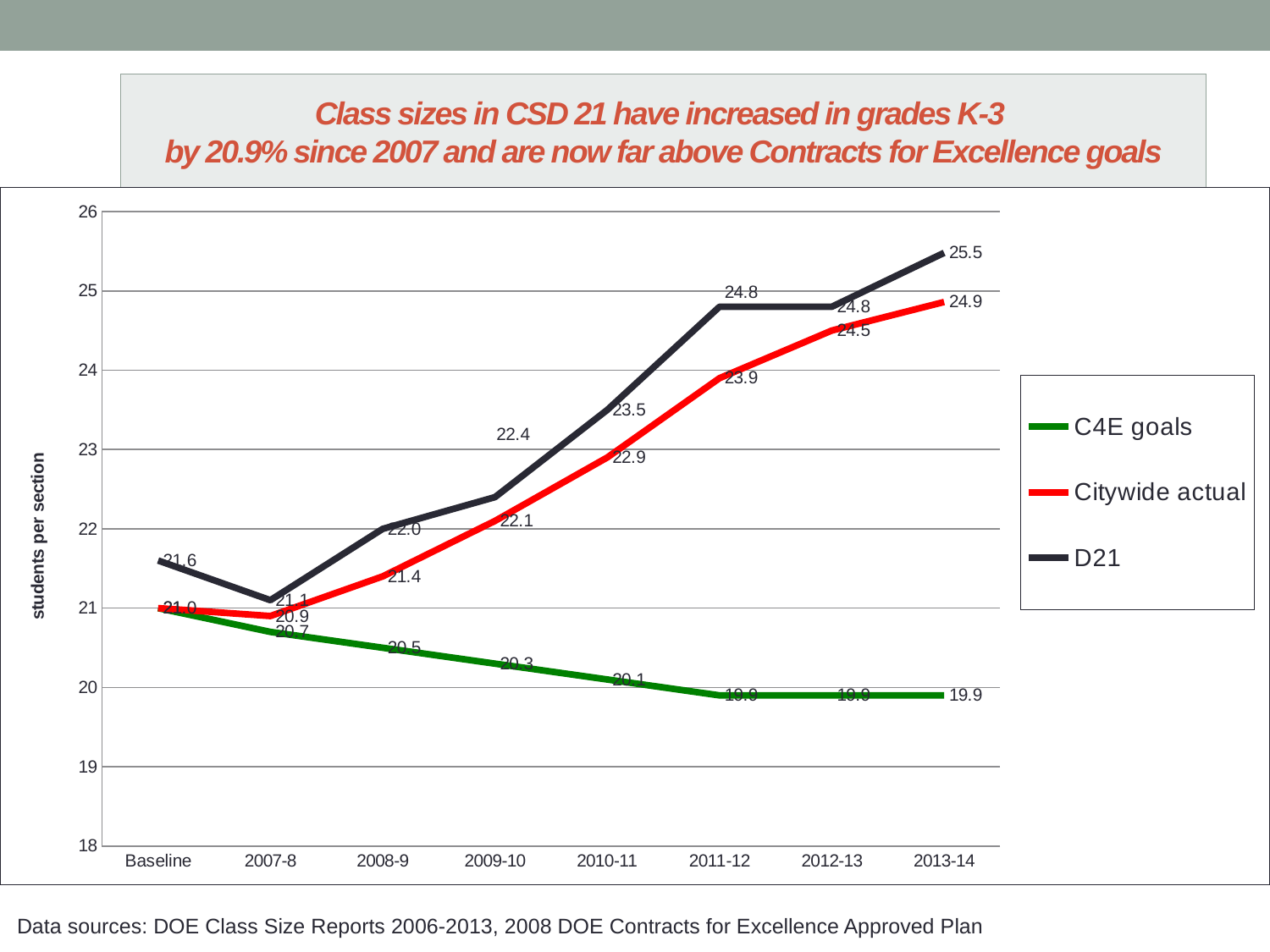
What is the D21 value for 2011-12? 24.8 In which year is the D21 series highest? 2013-14 What is the Citywide actual value for 2013-14? 24.9 What is the C4E goals value for 2009-10? 20.3 How many points are plotted along the x axis for each series? 8 What is the D21 value for 2013-14? 25.5 In which year is the D21 series lowest? 2007-8 In 2010-11, which is larger: the D21 value or the Citywide actual value? D21 What is the difference between the D21 value and the C4E goals value in 2013-14? 5.6 How many series does the legend list? 3 What kind of chart is shown on the slide? line chart Do the C4E goals values rise or fall from Baseline to 2013-14? fall